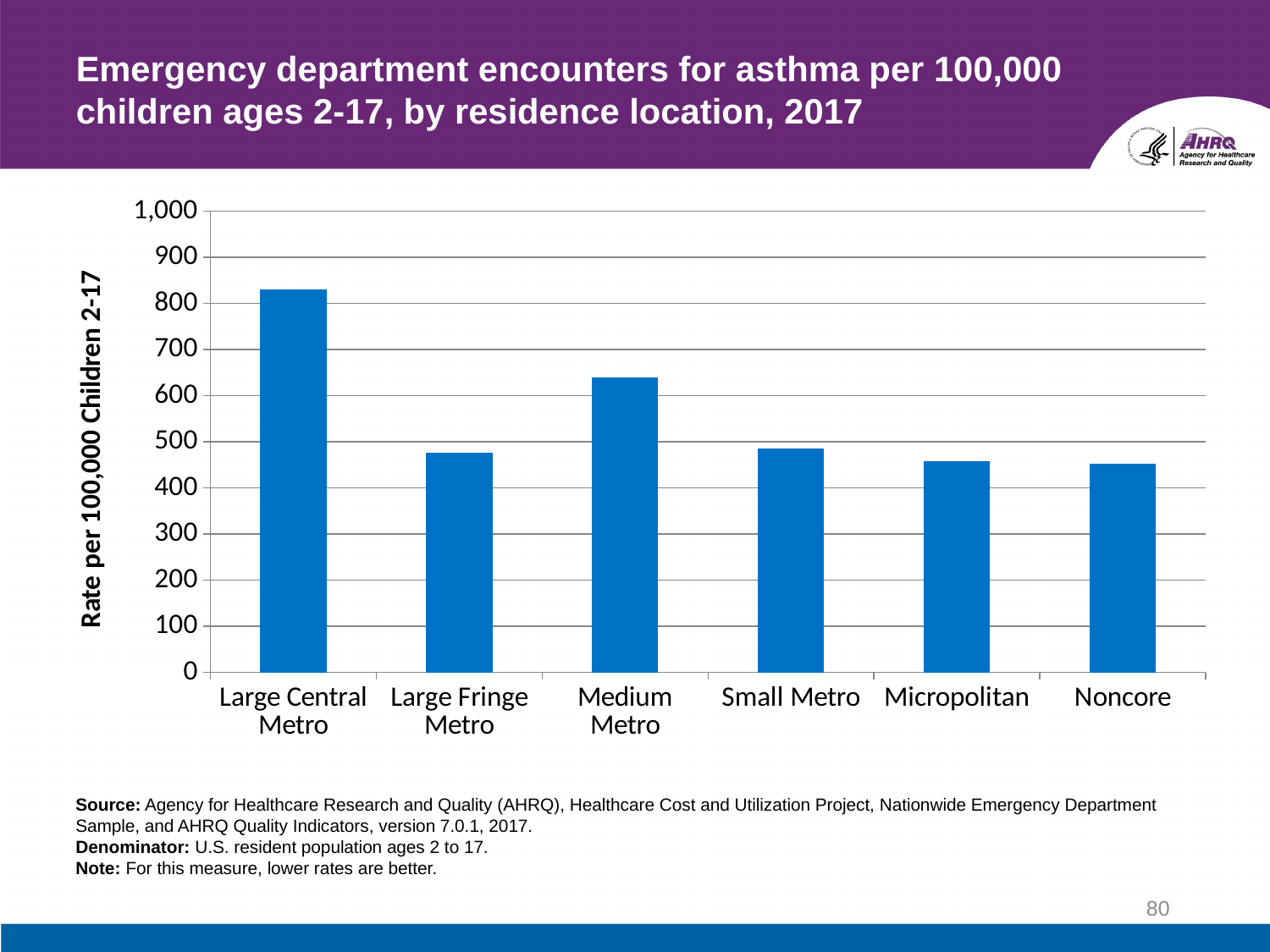
How many residence location categories are shown on the x axis? 6 Do the values rise or fall along the x axis from Medium Metro to Noncore? fall What kind of chart is shown on the slide? bar chart Is the value for Medium Metro greater or less than 700? less Is the value for Medium Metro greater or less than 600? greater What is the label of the y axis? Rate per 100,000 Children 2-17 Which residence location has the highest rate of emergency department encounters for asthma? Large Central Metro Is the value for Large Central Metro greater or less than 800? greater Which has a higher rate, Medium Metro or Small Metro? Medium Metro Which has a higher rate, Large Central Metro or Medium Metro? Large Central Metro